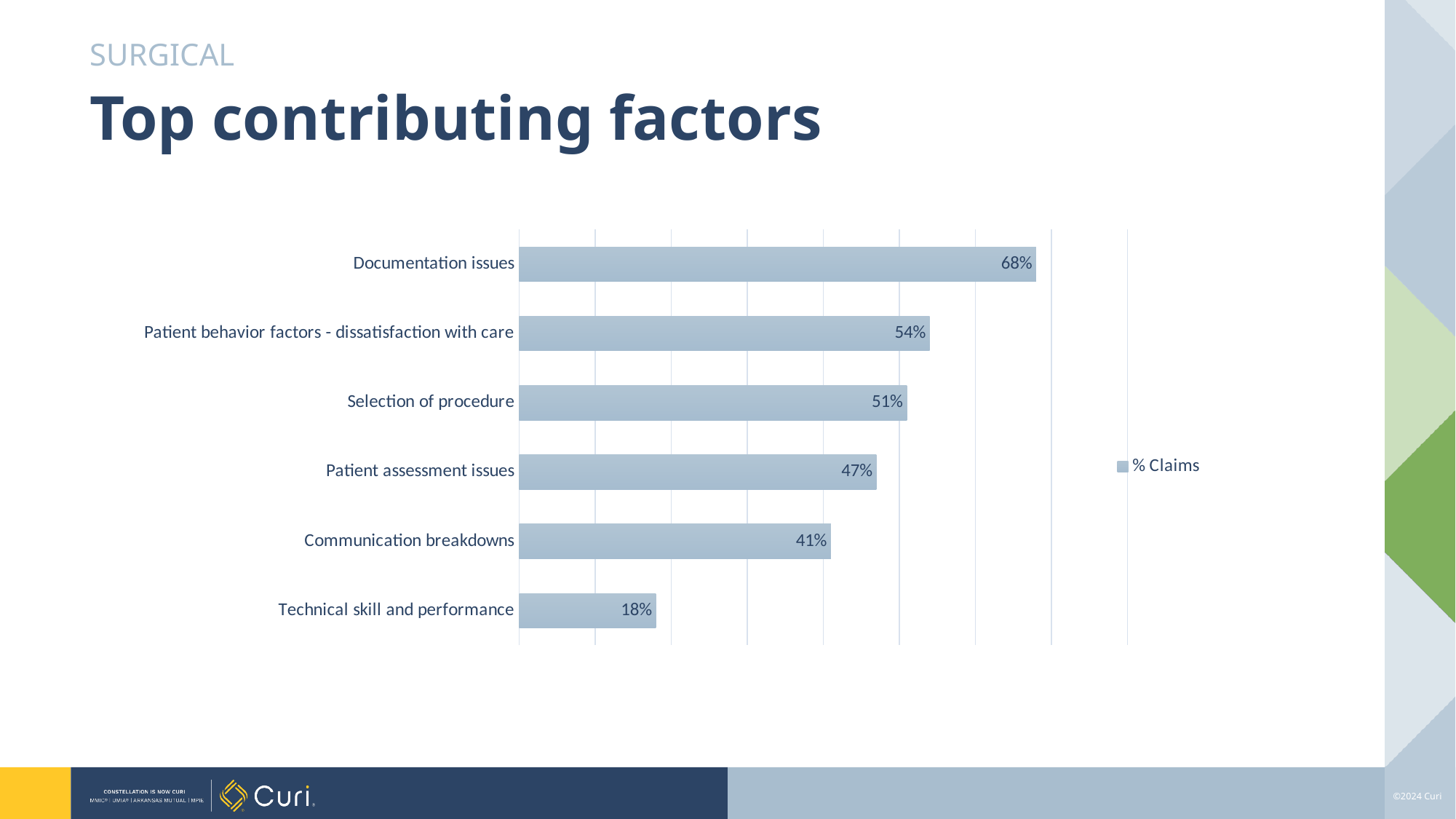
What is the value for Documentation issues? 68% Which category has the lowest value? Technical skill and performance What kind of chart is shown on the slide? Bar chart What is the value for Technical skill and performance? 18% Which category has the highest value? Documentation issues What is the difference between Selection of procedure and Patient assessment issues? 4% How many categories are shown in the chart? 6 What series name does the legend show? % Claims What is the value for Patient behavior factors - dissatisfaction with care? 54% Which is larger, Patient assessment issues or Communication breakdowns? Patient assessment issues What is the difference between Documentation issues and Technical skill and performance? 50% What is the value for Communication breakdowns? 41%